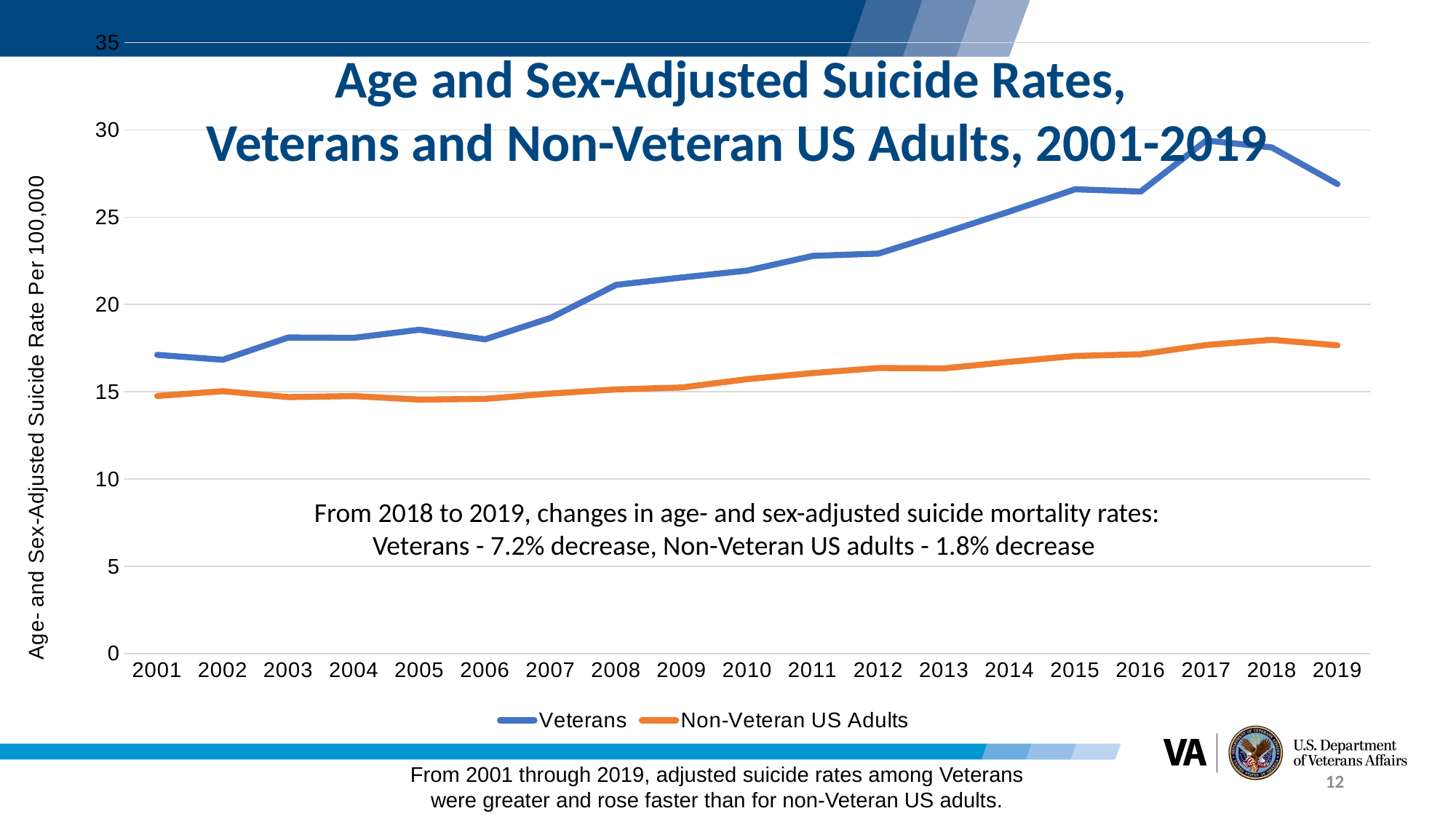
Is the Veterans value for 2017 greater or less than 30? less Is the Veterans value for 2008 greater or less than 20? greater How many years are plotted along the x axis? 19 Which colour is used for the Non-Veteran US Adults line? orange What is the label on the y axis? Age- and Sex-Adjusted Suicide Rate Per 100,000 In 2019, which series has the higher value, Veterans or Non-Veteran US Adults? Veterans What kind of chart is shown on the slide? line chart Overall from 2001 to 2019, does the Veterans line rise or fall? rise Is the Non-Veteran US Adults value for 2019 greater or less than 20? less How many series does the legend list? 2